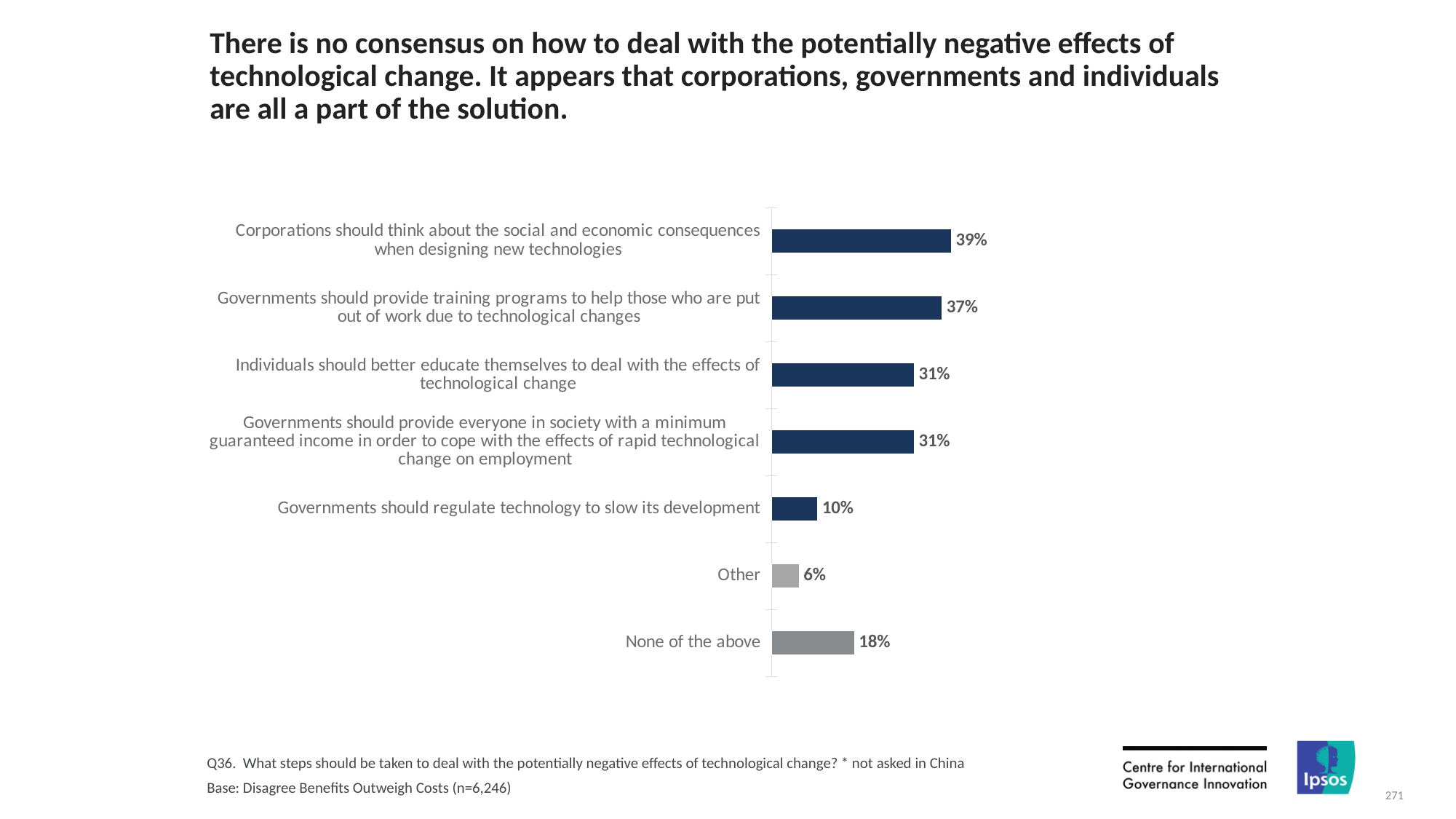
What value is shown for 'Other'? 6% Which bars are coloured grey rather than dark blue? Other and None of the above What is the difference between the value for governments providing training programs and the value for governments regulating technology to slow its development? 27% What percentage of respondents said corporations should think about the social and economic consequences when designing new technologies? 39% Which category has the highest value on the chart? Corporations should think about the social and economic consequences when designing new technologies What percentage chose 'None of the above'? 18% What value is shown for 'Individuals should better educate themselves to deal with the effects of technological change'? 31% What kind of chart is shown on the slide? Bar chart Which is larger: the value for 'None of the above' or the value for 'Governments should regulate technology to slow its development'? None of the above Which category has the lowest value on the chart? Other How many categories (bars) are shown on the chart? 7 What value is shown for 'Governments should regulate technology to slow its development'? 10%